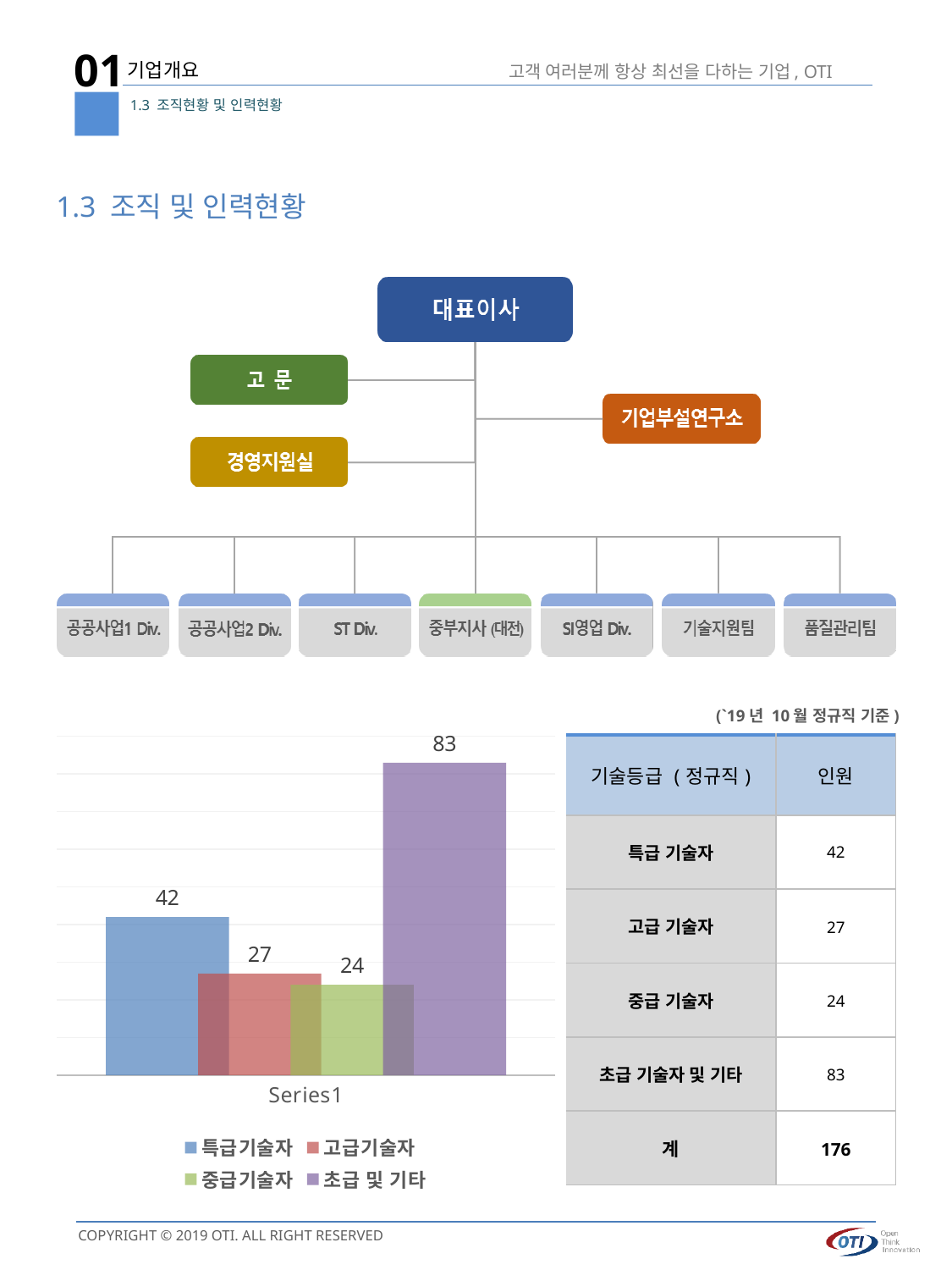
Which series has the lowest value in the bar chart? 중급기술자 What is the difference between the values for 고급기술자 and 중급기술자 in the bar chart? 3 What is the value for 중급기술자 in the bar chart? 24 What is the value for 특급기술자 in the bar chart? 42 What is the difference between the values for 초급 및 기타 and 특급기술자 in the bar chart? 41 What is the value for 초급 및 기타 in the bar chart? 83 Which is larger in the bar chart, 특급기술자 or 고급기술자? 특급기술자 How many series does the legend of the bar chart list? 4 What kind of chart is shown at the bottom left of the slide? bar chart Which series has the highest value in the bar chart? 초급 및 기타 What is the value for 고급기술자 in the bar chart? 27 What is the category label shown on the x axis of the bar chart? Series1